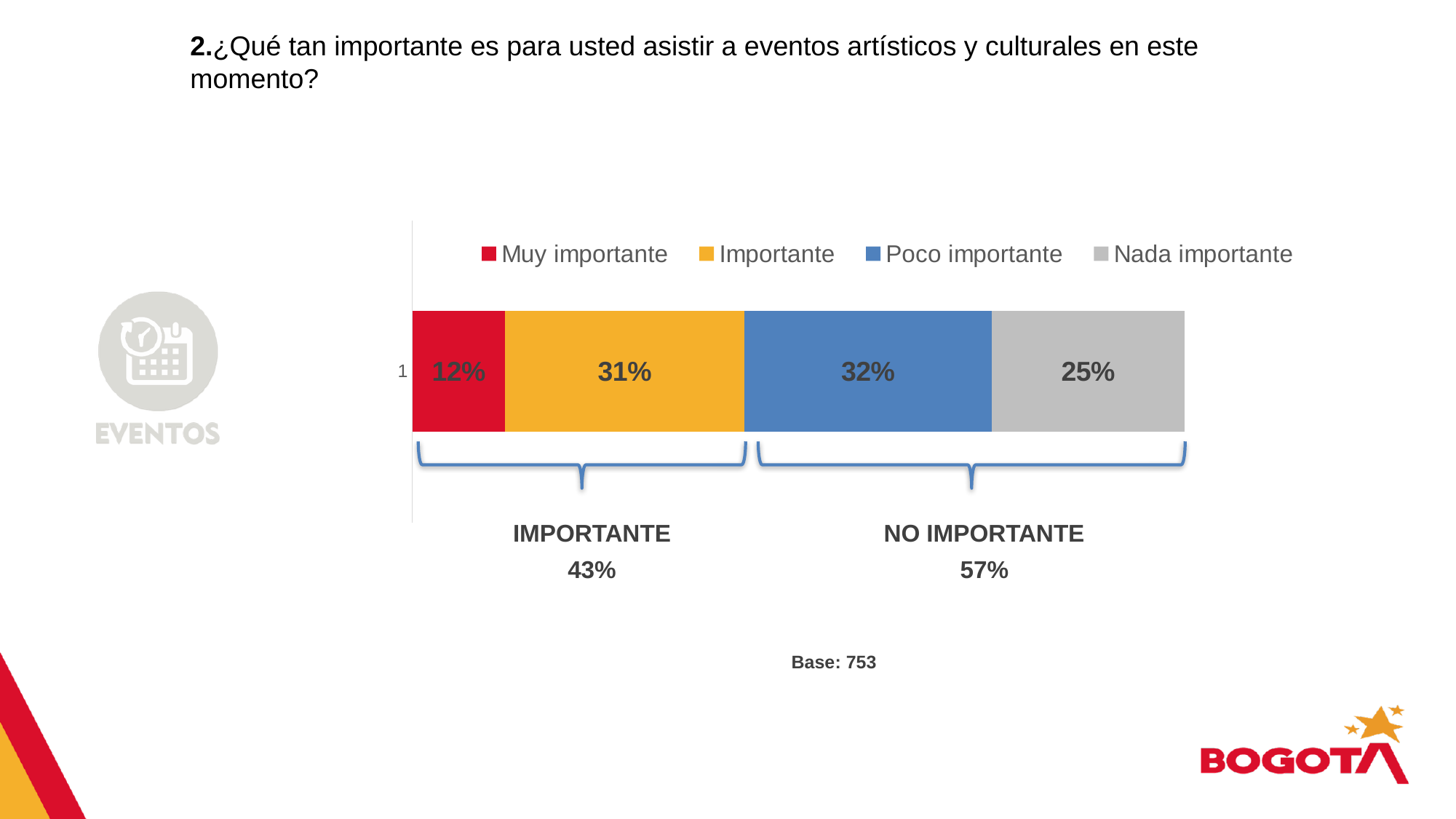
What percentage of respondents answered "Muy importante"? 12% What is the difference between the "Nada importante" and "Muy importante" shares? 13% What colour represents "Poco importante" in the chart? Blue What is the combined share labelled "NO IMPORTANTE" below the bar? 57% Which is larger, the share for "Importante" or the share for "Nada importante"? Importante What kind of chart is shown on the slide? Stacked bar chart How many series does the legend list? 4 What percentage of respondents answered "Nada importante"? 25% What is the combined share labelled "IMPORTANTE" below the bar? 43% What percentage of respondents answered "Poco importante"? 32% What percentage of respondents answered "Importante"? 31% Which response category has the smallest share? Muy importante